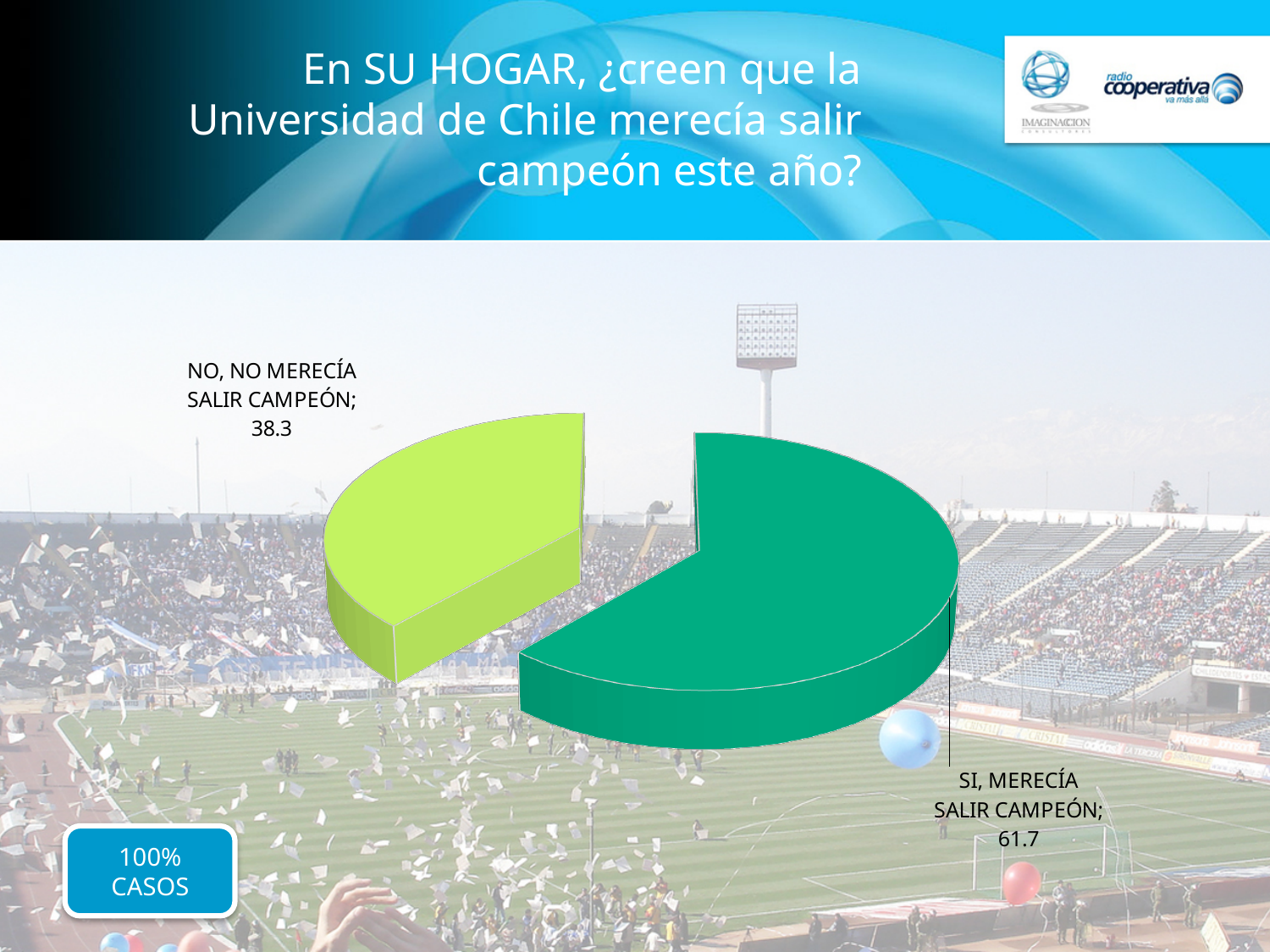
What is the difference between the "SI, MERECÍA SALIR CAMPEÓN" value and the "NO, NO MERECÍA SALIR CAMPEÓN" value? 23.4 Which slice of the pie is the smallest? NO, NO MERECÍA SALIR CAMPEÓN What value is shown for the slice labelled "NO, NO MERECÍA SALIR CAMPEÓN"? 38.3 What question is the chart on the slide about, according to the slide title? En SU HOGAR, ¿creen que la Universidad de Chile merecía salir campeón este año? What colour is the "NO, NO MERECÍA SALIR CAMPEÓN" slice? Light green What kind of chart is shown on the slide? Pie chart How many slices does the pie chart have? 2 Which slice of the pie is the largest? SI, MERECÍA SALIR CAMPEÓN What is the total of the two slice values shown on the pie chart? 100 Which is larger: the value for "SI, MERECÍA SALIR CAMPEÓN" or for "NO, NO MERECÍA SALIR CAMPEÓN"? SI, MERECÍA SALIR CAMPEÓN What value is shown for the slice labelled "SI, MERECÍA SALIR CAMPEÓN"? 61.7